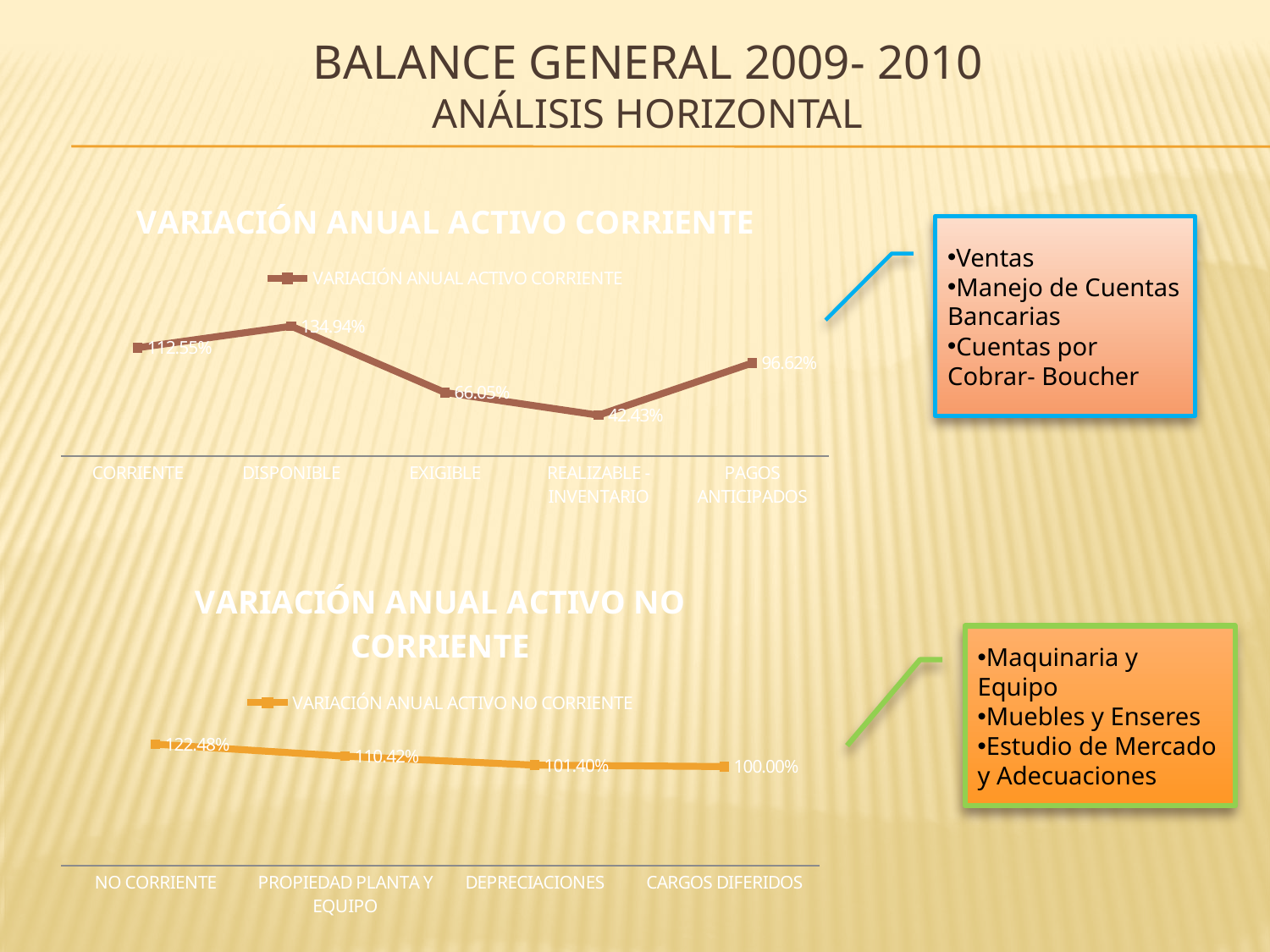
In the 'VARIACIÓN ANUAL ACTIVO CORRIENTE' chart, what is the value for DISPONIBLE? 134.94% In the 'VARIACIÓN ANUAL ACTIVO CORRIENTE' chart, which category has the lowest value? REALIZABLE - INVENTARIO In the 'VARIACIÓN ANUAL ACTIVO NO CORRIENTE' chart, what is the value for CARGOS DIFERIDOS? 100.00% In the 'VARIACIÓN ANUAL ACTIVO NO CORRIENTE' chart, what is the value for PROPIEDAD PLANTA Y EQUIPO? 110.42% What type of chart is the 'VARIACIÓN ANUAL ACTIVO CORRIENTE' chart? Line chart In the 'VARIACIÓN ANUAL ACTIVO NO CORRIENTE' chart, do the values rise or fall from left to right along the x axis? Fall In the 'VARIACIÓN ANUAL ACTIVO CORRIENTE' chart, what is the value for REALIZABLE - INVENTARIO? 42.43% In the 'VARIACIÓN ANUAL ACTIVO CORRIENTE' chart, how many categories are plotted? 5 In the 'VARIACIÓN ANUAL ACTIVO CORRIENTE' chart, what is the difference between the values for DISPONIBLE and EXIGIBLE? 68.89% In the 'VARIACIÓN ANUAL ACTIVO CORRIENTE' chart, which category has the highest value? DISPONIBLE In the 'VARIACIÓN ANUAL ACTIVO NO CORRIENTE' chart, which is larger, the value for NO CORRIENTE or the value for DEPRECIACIONES? NO CORRIENTE How many series does the legend of the 'VARIACIÓN ANUAL ACTIVO NO CORRIENTE' chart list? 1